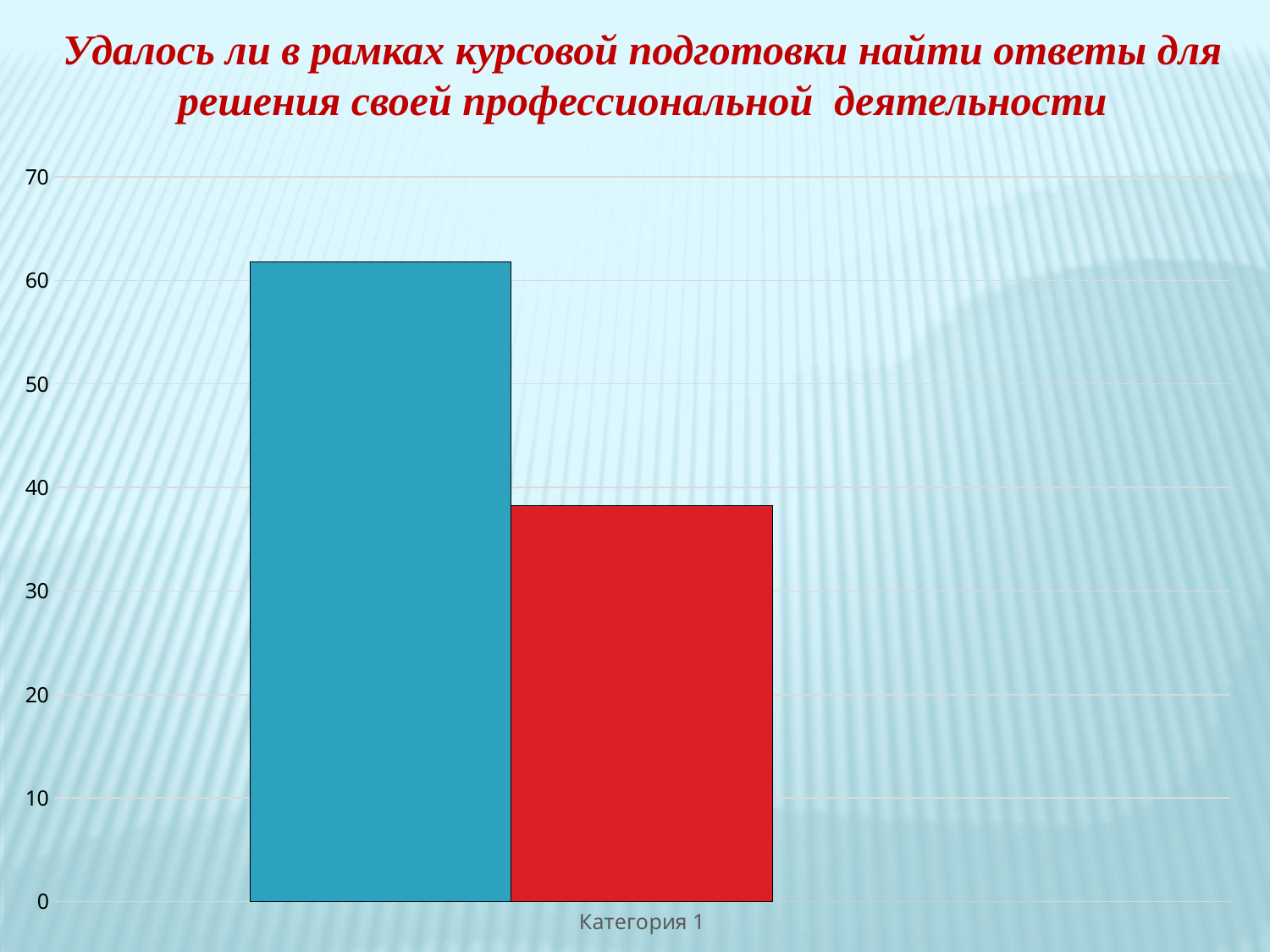
What kind of chart is shown on the slide? bar chart How many categories are shown on the x axis of the chart? 1 Is the value of the red bar greater or less than 30? greater Which bar has the lowest value in the chart? the red bar What is the label of the category on the x axis? Категория 1 Is the value of the blue bar greater or less than 60? greater Which bar is taller, the blue bar or the red bar? the blue bar How many bars are plotted in the chart? 2 What is the highest value shown on the vertical axis of the chart? 70 Is the value of the red bar greater or less than 50? less